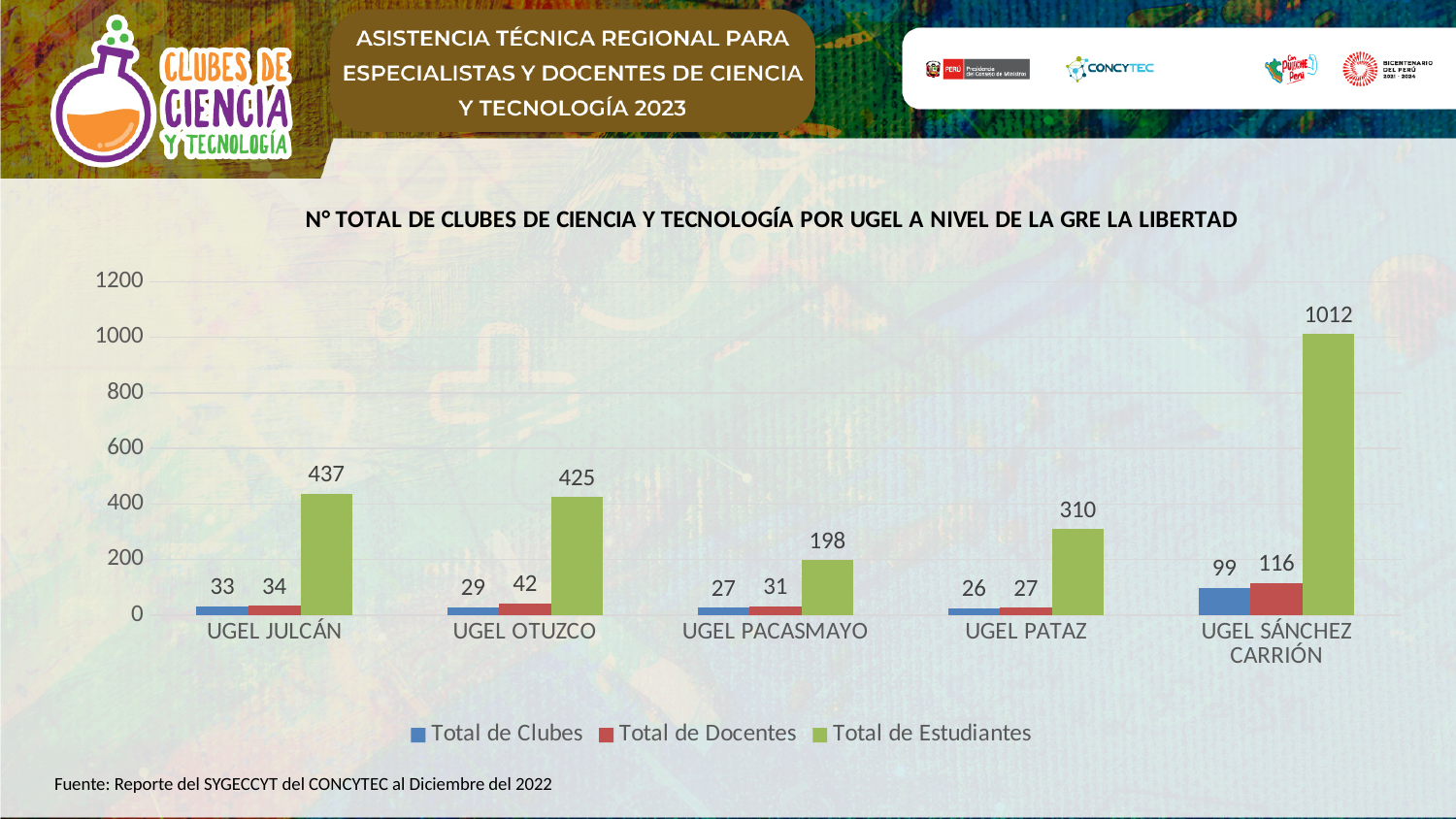
What is the title of the chart? N° TOTAL DE CLUBES DE CIENCIA Y TECNOLOGÍA POR UGEL A NIVEL DE LA GRE LA LIBERTAD Is the Total de Estudiantes for UGEL PATAZ greater or less than 400? less Which UGEL has the lowest Total de Estudiantes? UGEL PACASMAYO Which is larger: the Total de Docentes for UGEL SÁNCHEZ CARRIÓN or for UGEL JULCÁN? UGEL SÁNCHEZ CARRIÓN What is the Total de Docentes value for UGEL OTUZCO? 42 How many UGEL categories are shown on the x axis? 5 How many series does the legend list? 3 What is the Total de Clubes value for UGEL PATAZ? 26 What kind of chart is shown on the slide? bar chart What is the difference between the Total de Estudiantes for UGEL JULCÁN and UGEL OTUZCO? 12 Which UGEL has the highest Total de Estudiantes? UGEL SÁNCHEZ CARRIÓN What is the Total de Estudiantes value for UGEL SÁNCHEZ CARRIÓN? 1012